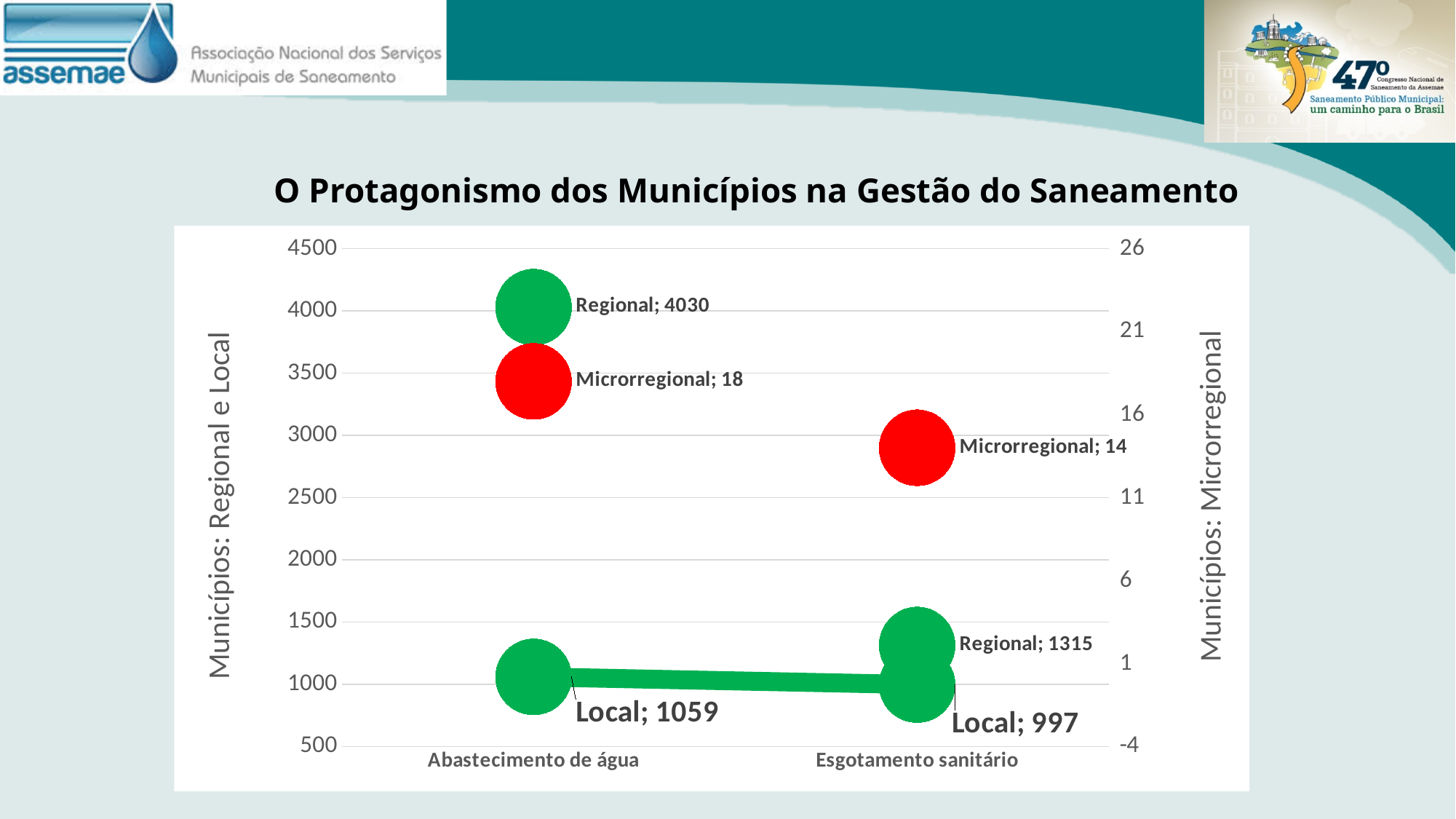
Which is larger, the Local value for Abastecimento de água or the Local value for Esgotamento sanitário? Abastecimento de água In which category is the Regional value highest? Abastecimento de água What is the difference between the Regional values for Abastecimento de água and Esgotamento sanitário? 2715 What is the value for Microrregional in the Abastecimento de água category? 18 What is the value for Microrregional in the Esgotamento sanitário category? 14 What is the value for Regional in the Abastecimento de água category? 4030 What is the value for Regional in the Esgotamento sanitário category? 1315 What is the value for Local in the Esgotamento sanitário category? 997 Does the Local series rise or fall from Abastecimento de água to Esgotamento sanitário? fall How many categories are shown on the x axis? 2 What is the title of the left vertical axis? Municípios: Regional e Local What is the difference between the Local values for Abastecimento de água and Esgotamento sanitário? 62